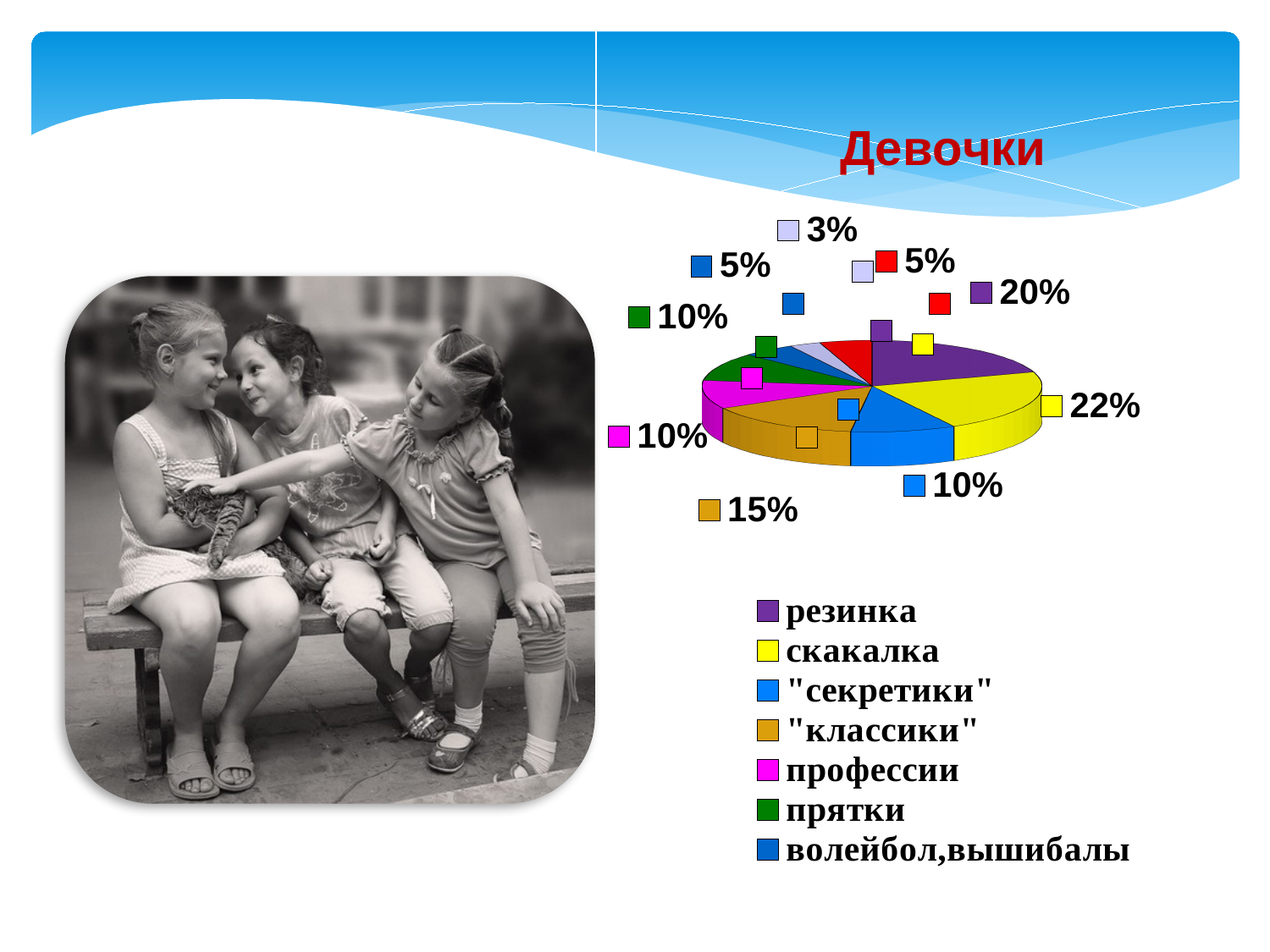
What is the title of the pie chart? Девочки What percentage does the волейбол,вышибалы slice represent? 5% What kind of chart is shown on the slide? pie chart Which is larger, the "классики" slice or the профессии slice? "классики" How much larger is the скакалка share than the резинка share? 2% What percentage does the прятки slice represent? 10% What percentage does the резинка slice represent? 20% Which legend category has the largest share of the pie? скакалка What is the smallest percentage labelled on the pie chart? 3% What percentage does the скакалка slice represent? 22% How many entries does the legend list? 7 What percentage does the "классики" slice represent? 15%